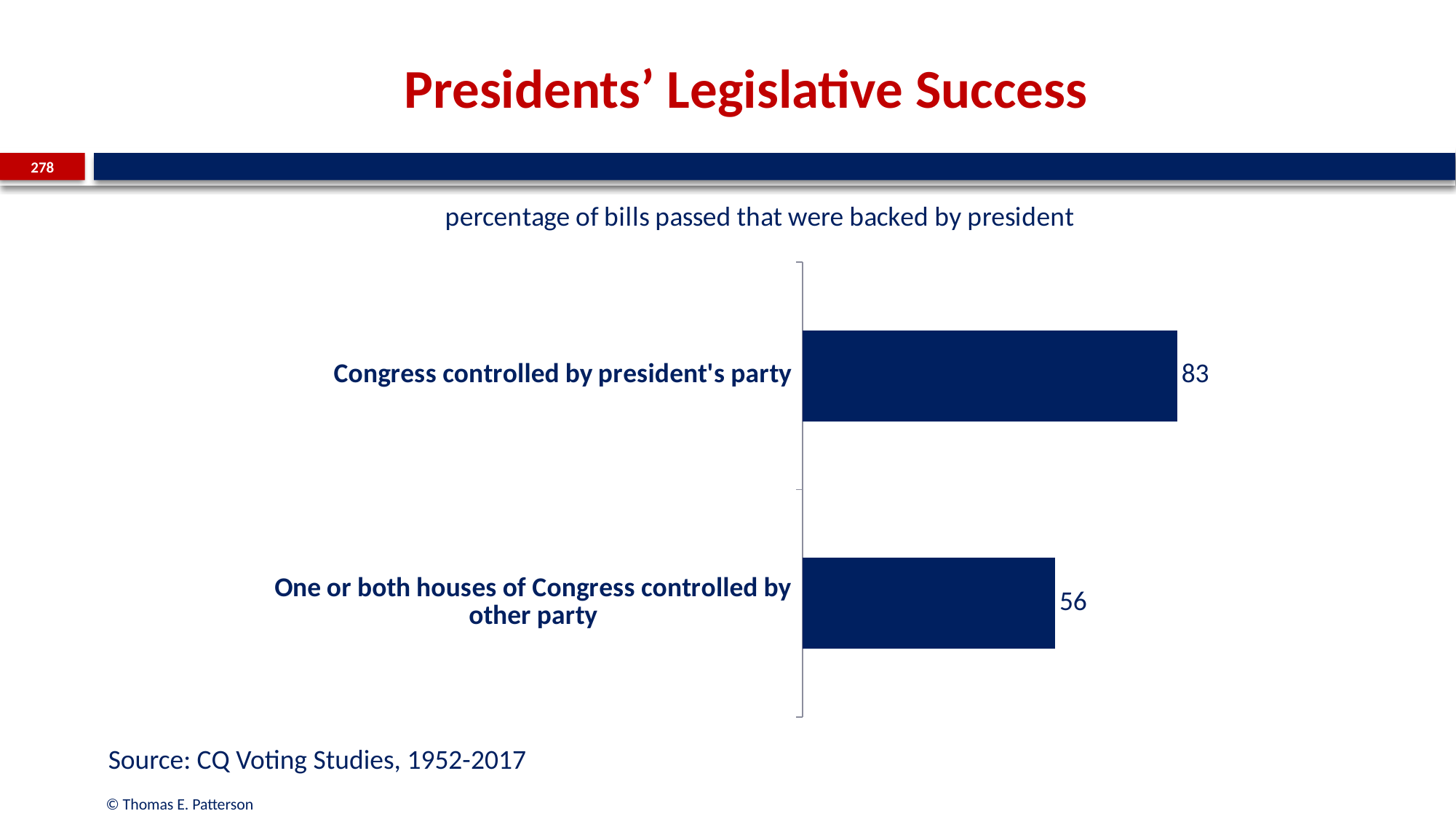
Which category has the highest value? Congress controlled by president's party What is the value for 'One or both houses of Congress controlled by other party'? 56 What is the title of the slide? Presidents' Legislative Success Which is larger: the value for 'Congress controlled by president's party' or the value for 'One or both houses of Congress controlled by other party'? Congress controlled by president's party What does the subtitle above the chart say the values represent? percentage of bills passed that were backed by president What kind of chart is shown on the slide? Bar chart What is the difference between the value for 'Congress controlled by president's party' and the value for 'One or both houses of Congress controlled by other party'? 27 How many categories are shown in the chart? 2 Which category has the lowest value? One or both houses of Congress controlled by other party What is the value for 'Congress controlled by president's party'? 83